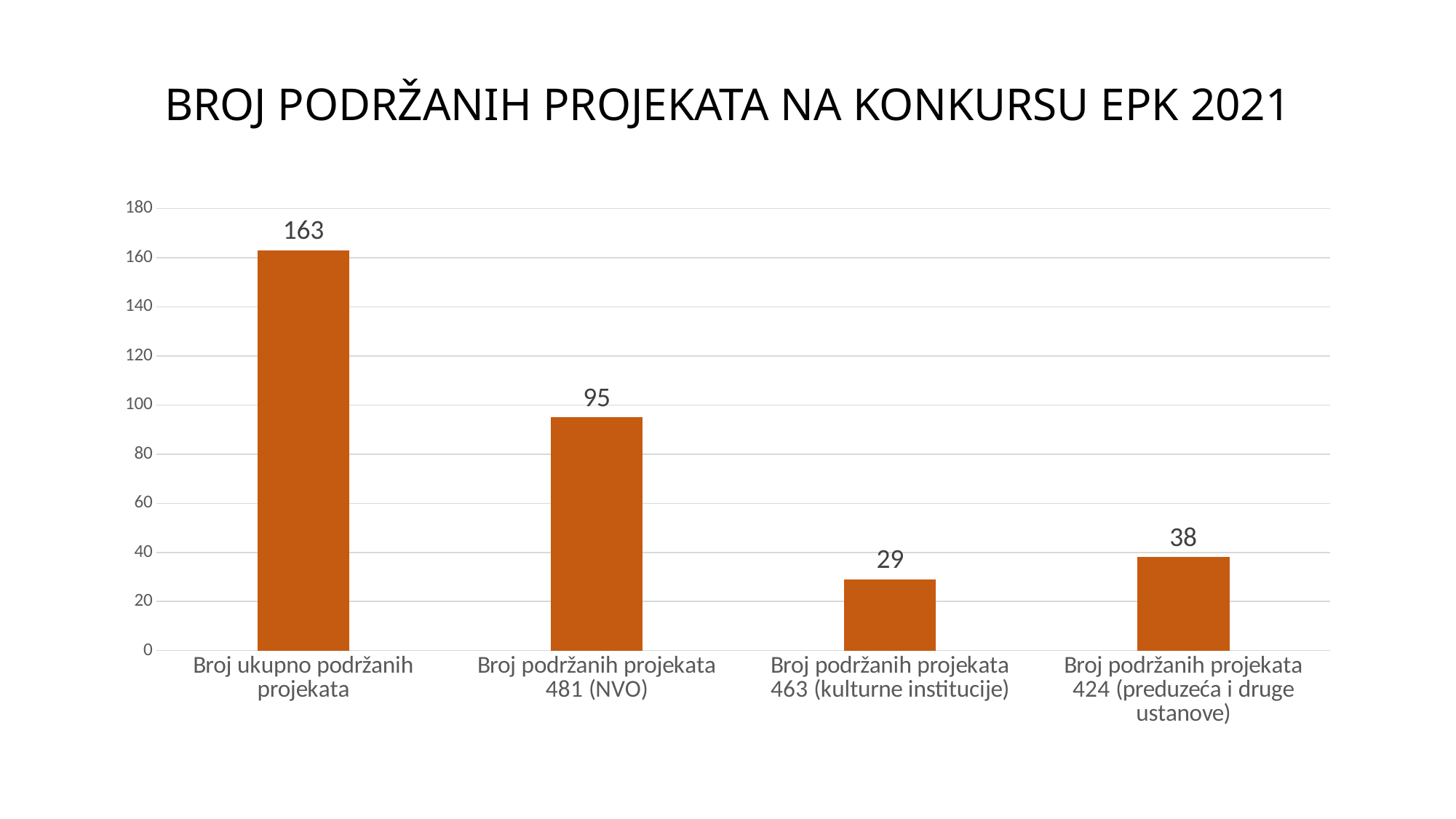
What is the difference between the values for 'Broj podržanih projekata 424 (preduzeća i druge ustanove)' and 'Broj podržanih projekata 463 (kulturne institucije)'? 9 What is the value for 'Broj podržanih projekata 463 (kulturne institucije)'? 29 Which category has the lowest value? Broj podržanih projekata 463 (kulturne institucije) Which is larger: the value for 'Broj podržanih projekata 481 (NVO)' or the value for 'Broj podržanih projekata 424 (preduzeća i druge ustanove)'? Broj podržanih projekata 481 (NVO) What is the value for 'Broj podržanih projekata 481 (NVO)'? 95 What is the value for 'Broj podržanih projekata 424 (preduzeća i druge ustanove)'? 38 What is the difference between the values for 'Broj ukupno podržanih projekata' and 'Broj podržanih projekata 481 (NVO)'? 68 How many categories are shown in the chart? 4 What kind of chart is shown on the slide? Bar chart What is the title of the chart? BROJ PODRŽANIH PROJEKATA NA KONKURSU EPK 2021 What is the value for 'Broj ukupno podržanih projekata'? 163 Which category has the highest value? Broj ukupno podržanih projekata